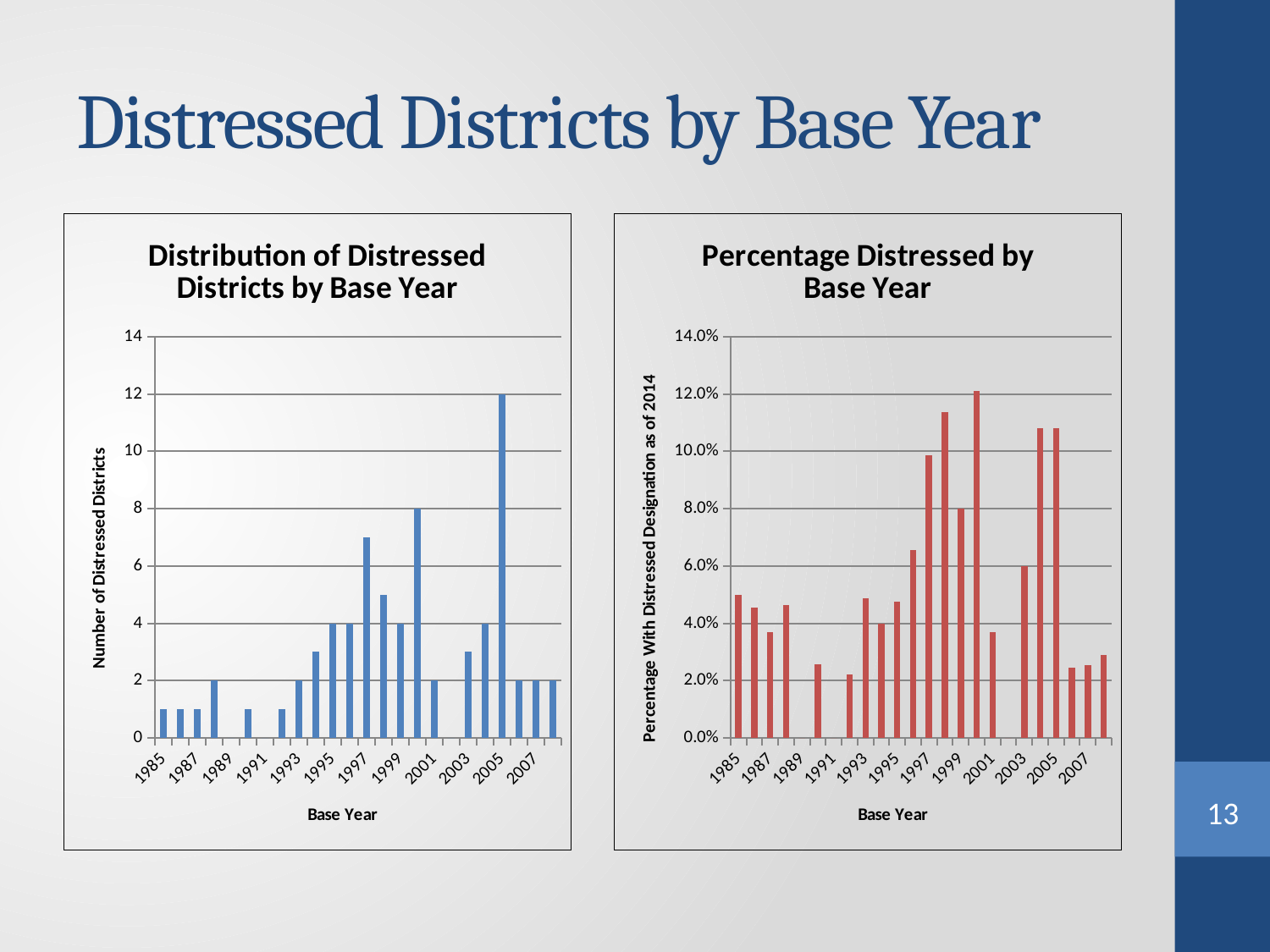
In the left chart, Distribution of Distressed Districts by Base Year, is the value for 1985 greater or less than 2? less In the left chart, Distribution of Distressed Districts by Base Year, is the value for 1997 greater or less than 6? greater In the right chart, Percentage Distressed by Base Year, is the value for 2007 greater or less than 4.0%? less In the left chart, Distribution of Distressed Districts by Base Year, how many distressed districts have a base year of 1995? 4 In the left chart, Distribution of Distressed Districts by Base Year, how many distressed districts have a base year of 2005? 12 In the left chart, Distribution of Distressed Districts by Base Year, what is the difference between the number of distressed districts for 2005 and for 1999? 8 In the right chart, Percentage Distressed by Base Year, which is larger, the value for 2005 or the value for 2007? 2005 In the left chart, Distribution of Distressed Districts by Base Year, how many distressed districts have a base year of 2007? 2 What is the y-axis title of the right chart, Percentage Distressed by Base Year? Percentage With Distressed Designation as of 2014 In the left chart, Distribution of Distressed Districts by Base Year, which base year has the highest number of distressed districts? 2005 What kind of chart is the right chart, Percentage Distressed by Base Year? bar chart